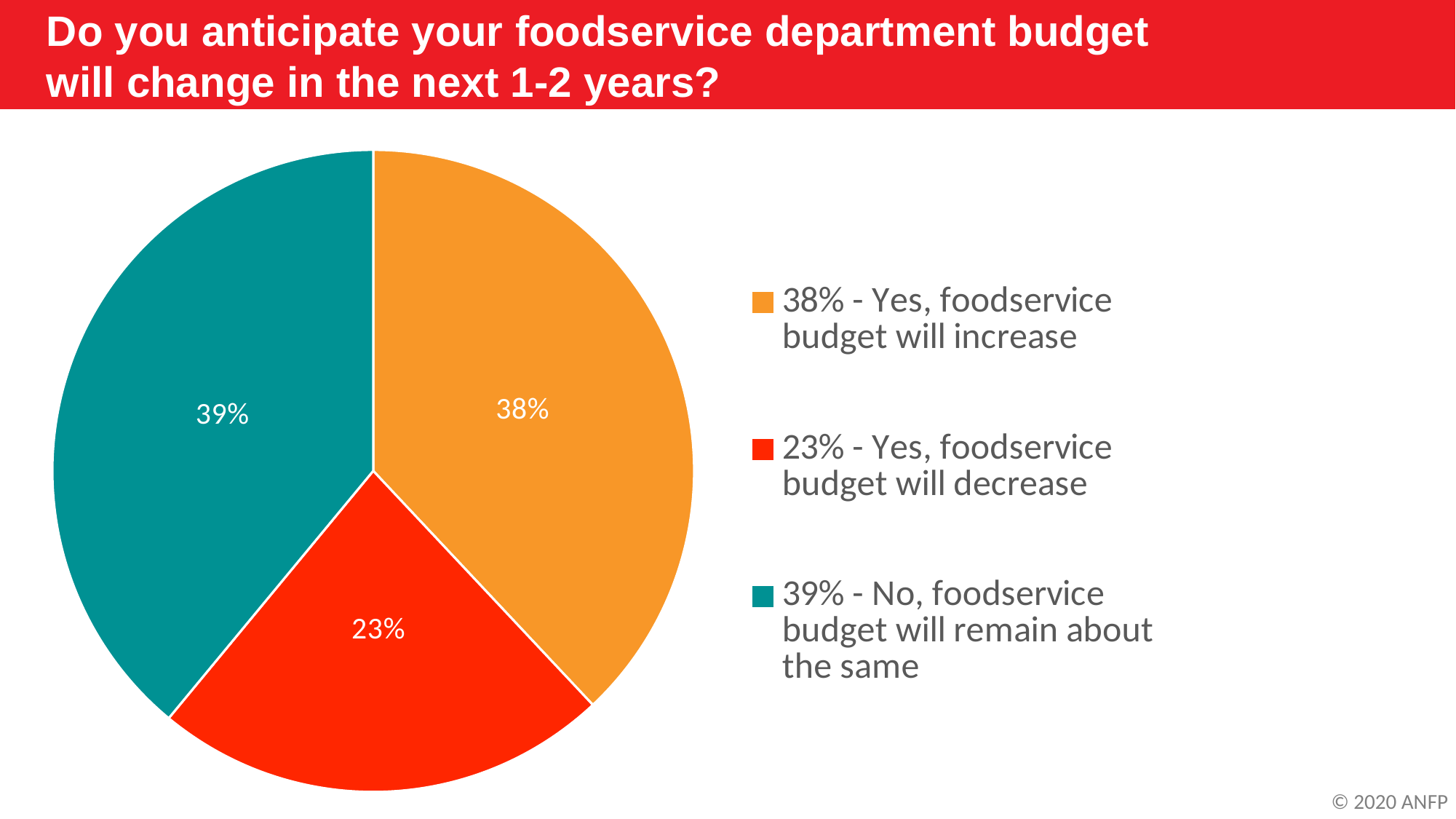
What share of respondents said their foodservice budget will decrease? 23% How many entries does the legend list? 3 Which response has the smallest slice of the pie? Yes, foodservice budget will decrease How many slices does the pie chart have? 3 What share of respondents said their foodservice budget will remain about the same? 39% What share of respondents said their foodservice budget will increase? 38% What is the difference in percentage points between the 'budget will remain about the same' slice and the 'budget will decrease' slice? 16 What is the title of the slide? Do you anticipate your foodservice department budget will change in the next 1-2 years? Which is larger: the share saying the budget will increase or the share saying it will decrease? Budget will increase What is the difference in percentage points between the 'budget will increase' slice and the 'budget will decrease' slice? 15 What colour is the slice for 'No, foodservice budget will remain about the same'? Teal What kind of chart is shown on the slide? Pie chart